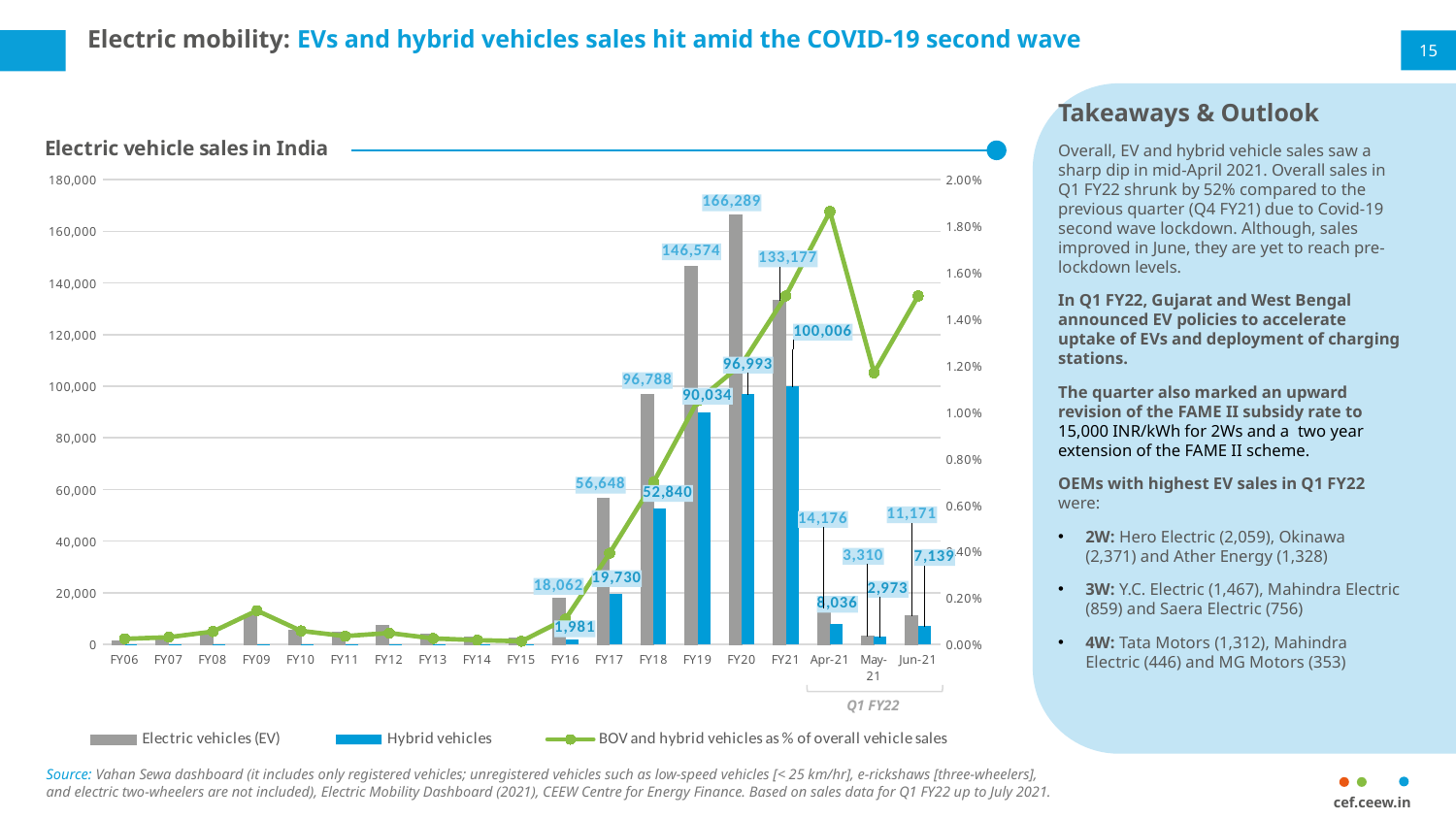
By how much did electric vehicle (EV) sales in Apr-21 exceed those in Jun-21? 3,005 In FY21, which was larger: electric vehicle (EV) sales or hybrid vehicle sales? Electric vehicles (EV) In which period were electric vehicle (EV) sales highest? FY20 What is the difference between electric vehicle (EV) sales and hybrid vehicle sales in FY20? 69,296 What were hybrid vehicle sales in FY21? 100,006 How many series does the chart legend list? 3 How many periods are shown on the x axis of the chart? 19 What were electric vehicle (EV) sales in India in FY20? 166,289 Among Apr-21, May-21 and Jun-21, which month had the lowest electric vehicle (EV) sales? May-21 What kind of chart is 'Electric vehicle sales in India'? Combination bar and line chart Is the value of BOV and hybrid vehicles as % of overall vehicle sales in Apr-21 greater or less than 1.60%? greater What were hybrid vehicle sales in May-21? 2,973